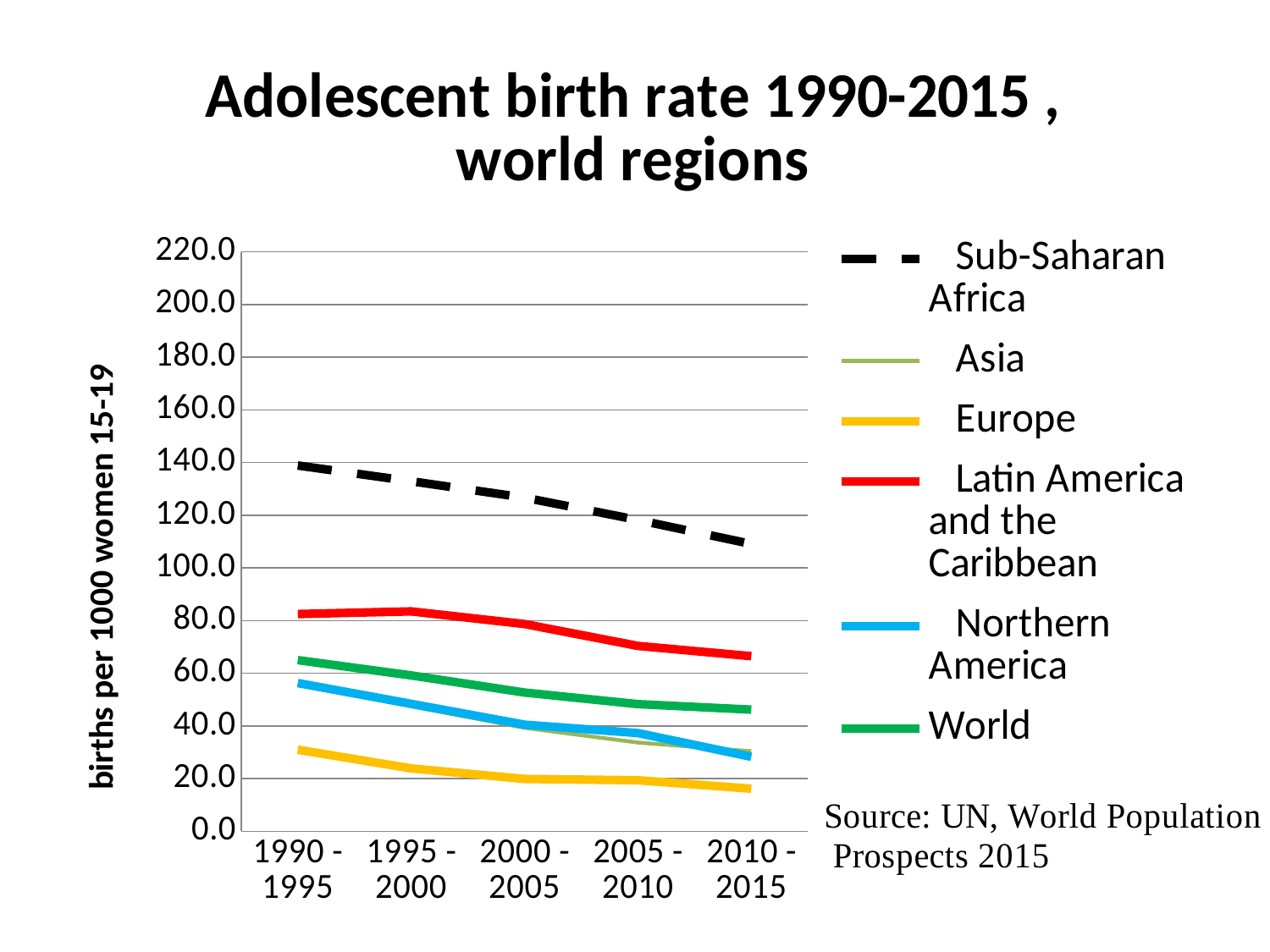
Does the Sub-Saharan Africa line rise or fall from 1990 - 1995 to 2010 - 2015? fall Which region has the highest adolescent birth rate in 1990 - 1995? Sub-Saharan Africa What is the title of the y axis? births per 1000 women 15-19 Is the value for Europe in 2010 - 2015 greater or less than 20.0? less Is the value for Latin America and the Caribbean in 2010 - 2015 greater or less than 60.0? greater In 2010 - 2015, which is larger: the value for Latin America and the Caribbean or the value for World? Latin America and the Caribbean Is the value for Sub-Saharan Africa in 2010 - 2015 greater or less than 120.0? less What kind of chart is shown on the slide? line chart How many time periods are shown on the x axis? 5 How many series does the legend list? 6 Which region has the lowest adolescent birth rate in 2010 - 2015? Europe